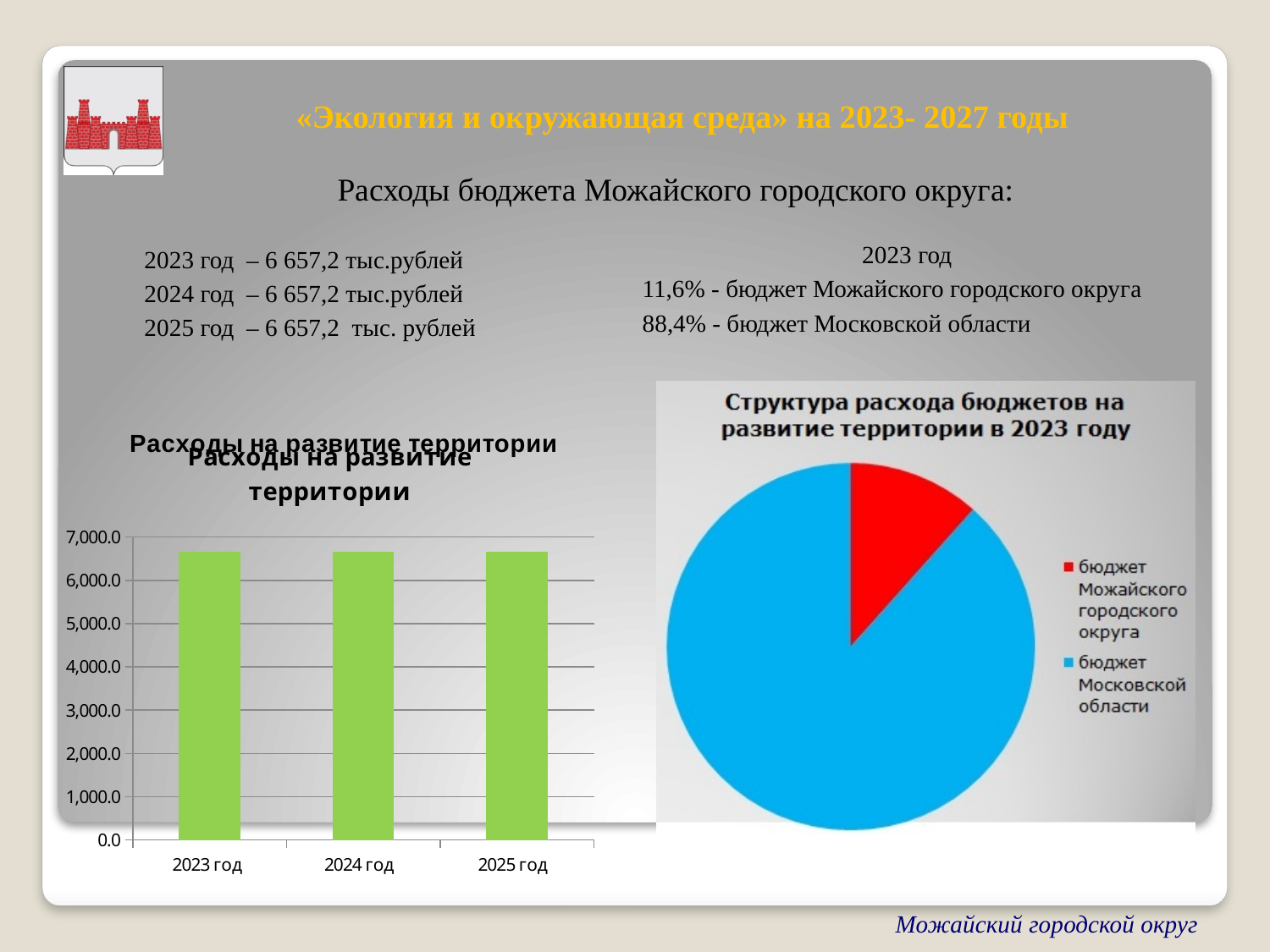
In the bar chart «Расходы на развитие территории», how many bars are plotted? 3 In the pie chart «Структура расхода бюджетов на развитие территории в 2023 году», which slice is the largest? бюджет Московской области In the bar chart «Расходы на развитие территории», is the value for 2025 год greater or less than 7,000.0? less In the bar chart «Расходы на развитие территории», is the value for 2023 год greater or less than 6,000.0? greater What kind of chart is the chart titled «Расходы на развитие территории»? bar chart In the pie chart «Структура расхода бюджетов на развитие территории в 2023 году», which slice is the smallest? бюджет Можайского городского округа In the bar chart «Расходы на развитие территории», do the values rise, fall or stay level from 2023 год to 2025 год? stay level In the pie chart «Структура расхода бюджетов на развитие территории в 2023 году», which is larger: бюджет Можайского городского округа or бюджет Московской области? бюджет Московской области What kind of chart is the chart titled «Структура расхода бюджетов на развитие территории в 2023 году»? pie chart In the bar chart «Расходы на развитие территории», is the value for 2024 год greater or less than 5,000.0? greater In the pie chart «Структура расхода бюджетов на развитие территории в 2023 году», how many entries does the legend list? 2 In the pie chart «Структура расхода бюджетов на развитие территории в 2023 году», what colour is the slice for бюджет Можайского городского округа? red